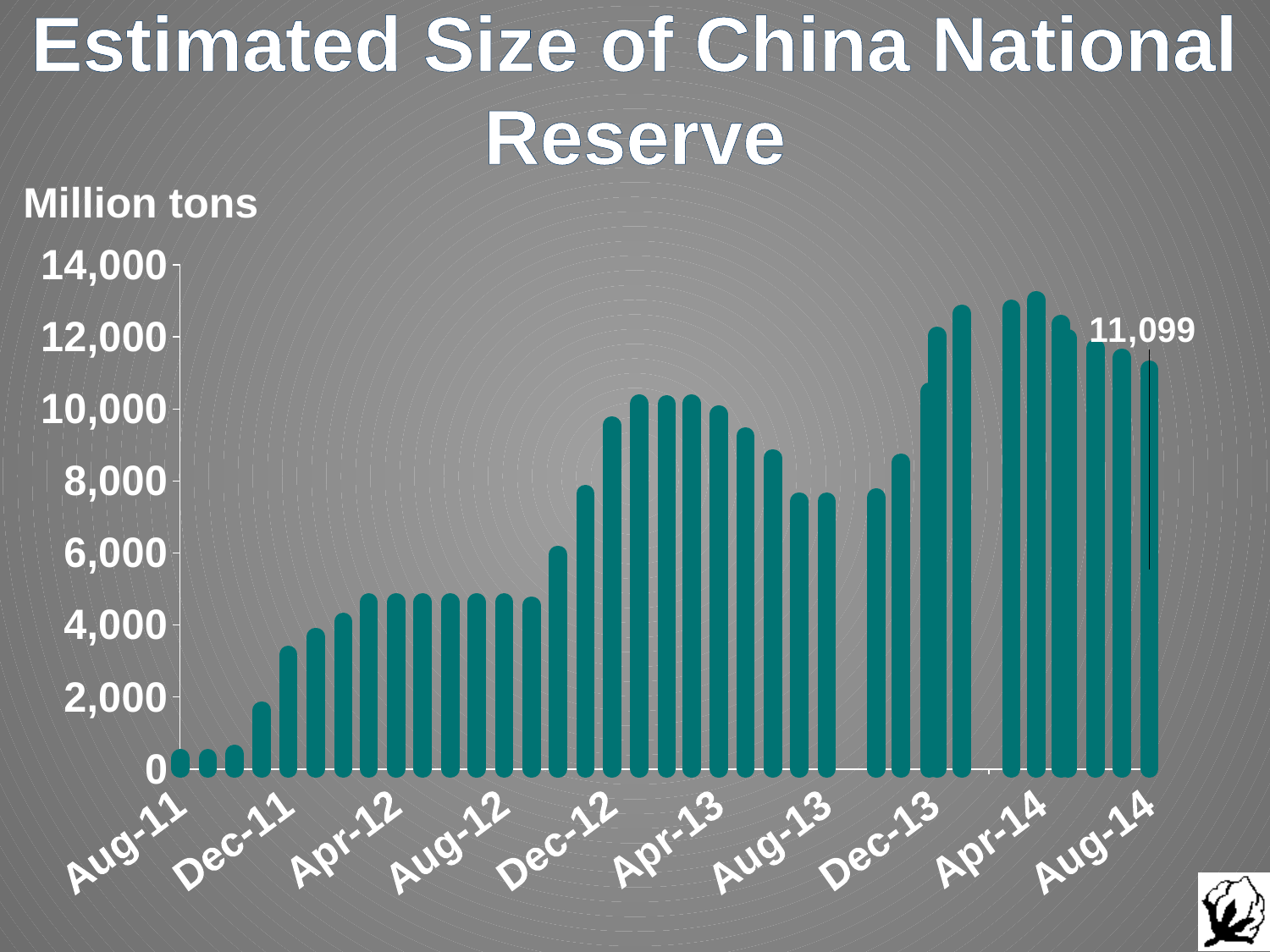
Is the value for Aug-11 greater or less than 2,000? less What is the value shown for Aug-14? 11,099 Is the value for Apr-12 greater or less than 4,000? greater Do the values rise or fall from Aug-11 to Apr-12? rise Is the value for Aug-14 greater or less than 10,000? greater What is the title of the chart? Estimated Size of China National Reserve Which is larger, the value for Aug-12 or the value for Aug-13? Aug-13 Which is larger, the value for Apr-12 or the value for Apr-13? Apr-13 What kind of chart is shown on the slide? Bar chart What unit is given for the values on the chart? Million tons